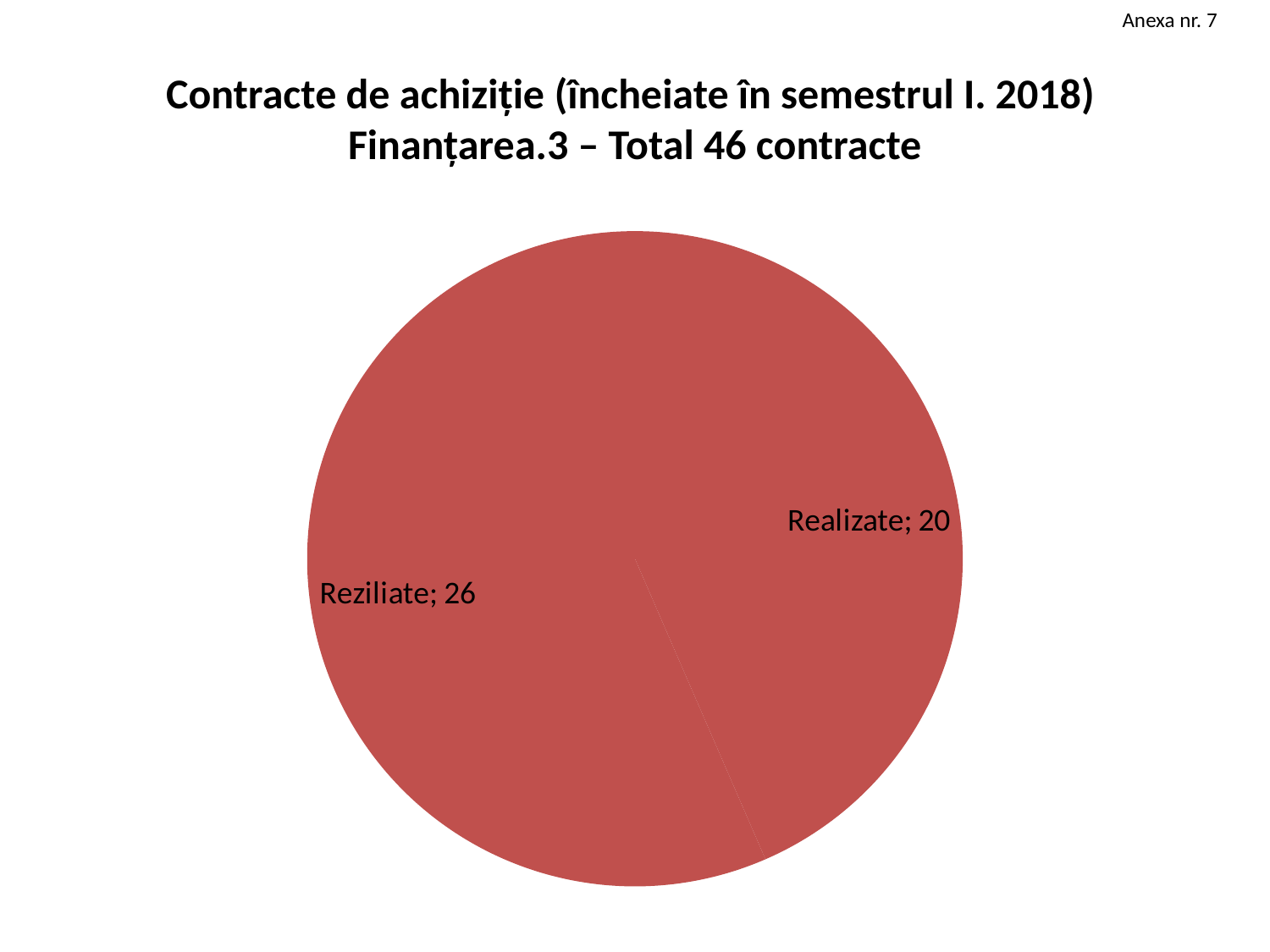
What is the difference between the number of Reziliate and Realizate contracts? 6 What type of chart is shown on the slide? pie chart How many contracts are labelled as Reziliate? 26 What is the title of the chart? Contracte de achiziție (încheiate în semestrul I. 2018) Finanțarea.3 – Total 46 contracte Which slice of the pie is the smallest? Realizate What is the total number of contracts shown in the pie chart? 46 How many contracts are labelled as Realizate? 20 Which slice of the pie is the largest? Reziliate How many slices does the pie chart have? 2 Which category has the larger number of contracts, Realizate or Reziliate? Reziliate What annex number is indicated in the top right corner of the slide? Anexa nr. 7